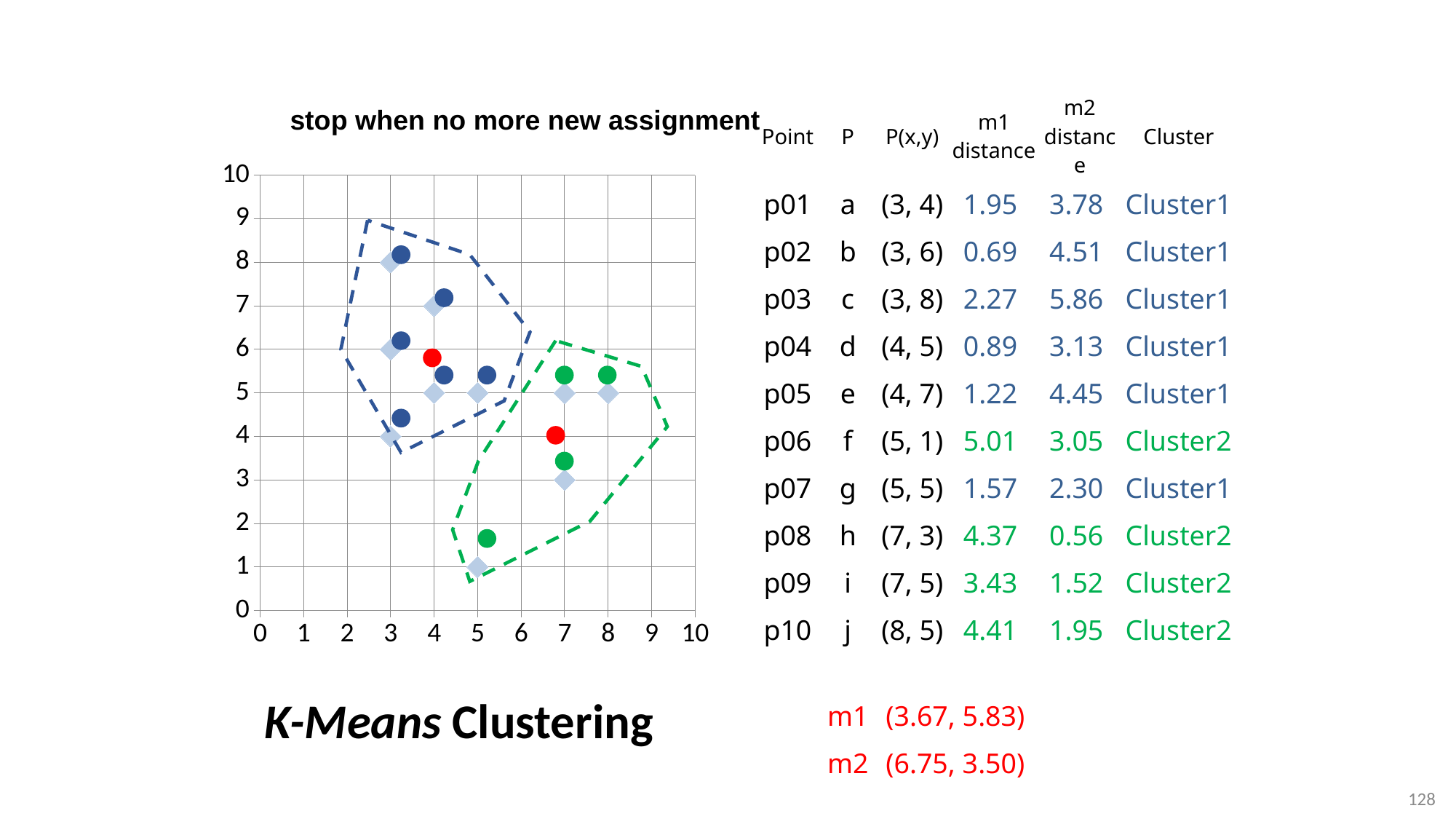
What is the title printed above the chart? stop when no more new assignment How many points are assigned to Cluster2 (green circles) on the chart? 4 How many data points (light-blue diamonds) are plotted on the chart? 10 Which point has the lowest y value on the chart? f (5, 1) Which point has the largest x value on the chart? j (8, 5) What are the coordinates of the centroid m1? (3.67, 5.83) What are the coordinates of point a (p01)? (3, 4) Which point has the highest y value on the chart? c (3, 8) What kind of chart is shown on the slide? scatter chart Is the x coordinate of centroid m2 greater or less than 6? greater What is the difference in y value between point c (3, 8) and point f (5, 1)? 7 What are the coordinates of the centroid m2? (6.75, 3.50)